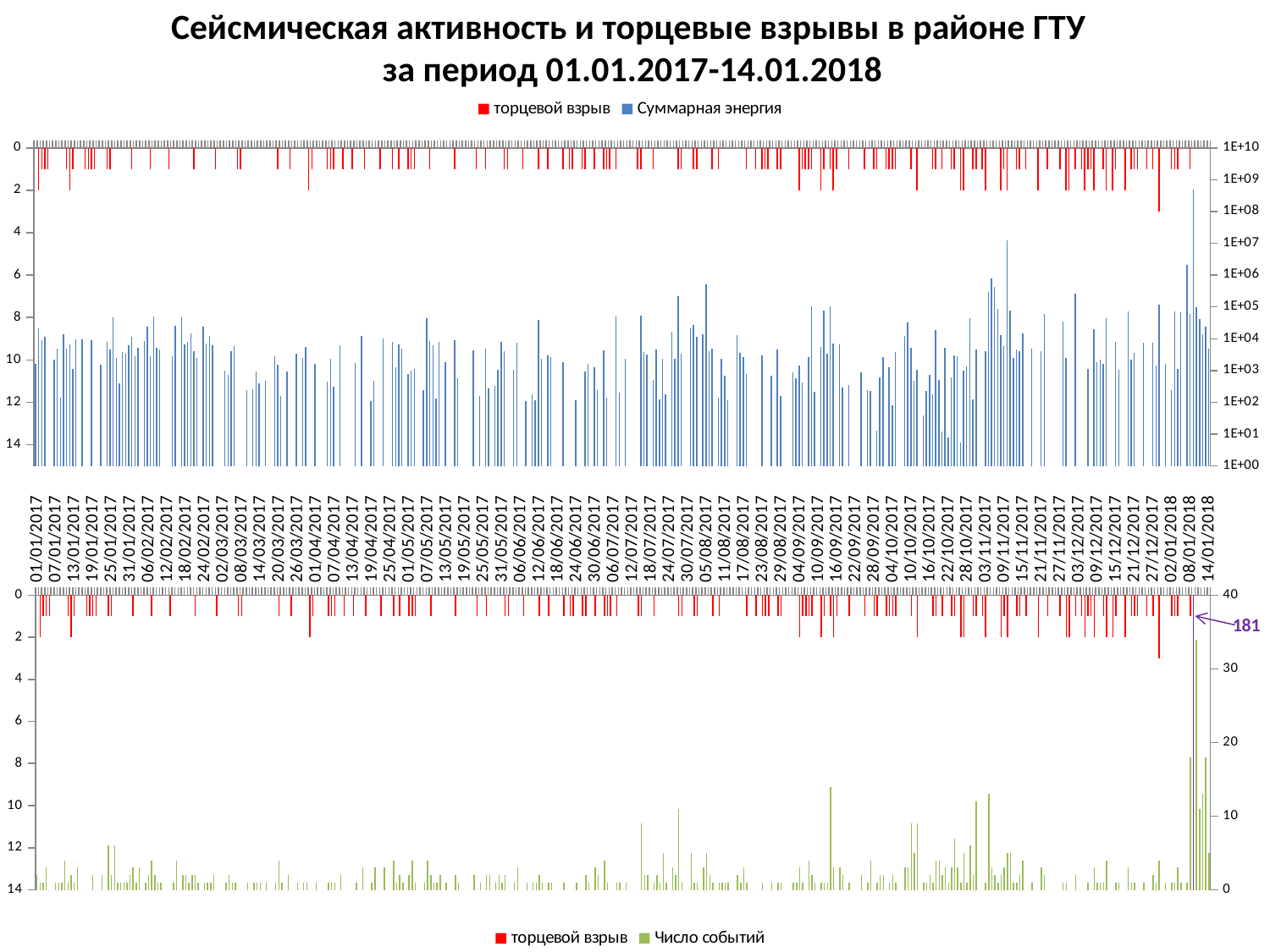
What period is stated in the slide title? 01.01.2017-14.01.2018 How many series does the legend of the top chart list? 2 What is the highest tick value on the right-hand axis of the bottom chart? 40 Which series appears in the legends of both the top and the bottom chart? торцевой взрыв In the bottom chart, what value is printed as a data label next to the tallest green bar? 181 In the bottom chart, is the tallest 'Число событий' bar greater or less than 20 on the right-hand axis? greater What kind of chart is the top chart on the slide? bar chart In the top chart, is the tallest 'Суммарная энергия' bar greater or less than 1E+06 on the right-hand axis? greater How many series does the legend of the bottom chart list? 2 What is the highest tick value on the right-hand axis of the top chart? 1E+10 In the bottom chart, which series has the highest bar: 'торцевой взрыв' or 'Число событий'? Число событий